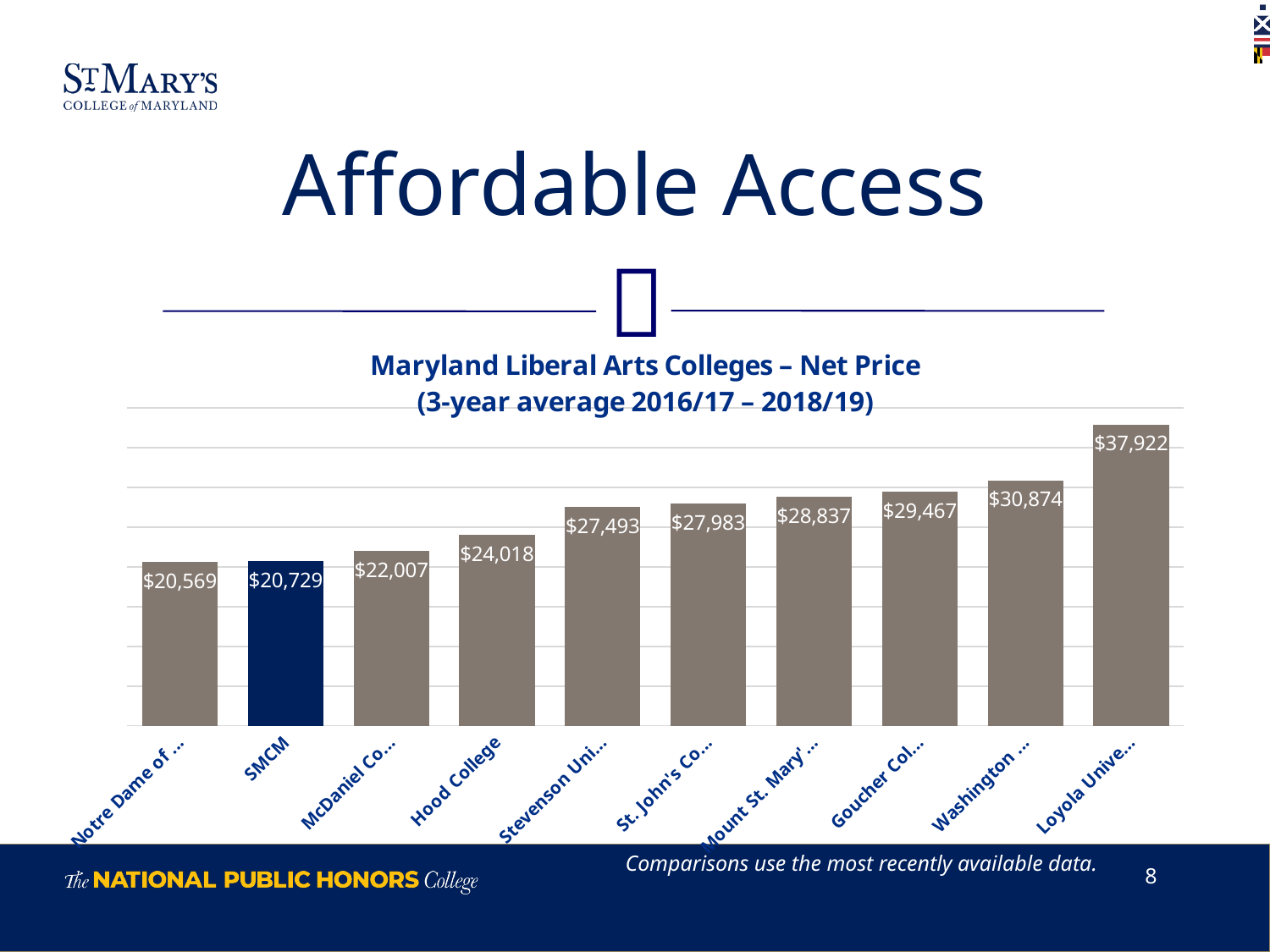
Which college has the highest net price in the chart? Loyola Unive... What type of chart is shown on the slide? Bar chart What is the net price shown for the bar labeled Goucher Col...? $29,467 How many colleges are shown in the chart? 10 What is the net price shown for Hood College? $24,018 Which college has the lowest net price in the chart? Notre Dame of ... What is the difference between the net price for Loyola Unive... and the net price for SMCM? $17,193 What is the difference between the net price for SMCM and the net price for Notre Dame of ...? $160 What is the net price shown for SMCM? $20,729 Which has a higher net price, Hood College or SMCM? Hood College What is the net price shown for the bar labeled Stevenson Uni...? $27,493 Do the net prices rise or fall from left to right across the chart? Rise